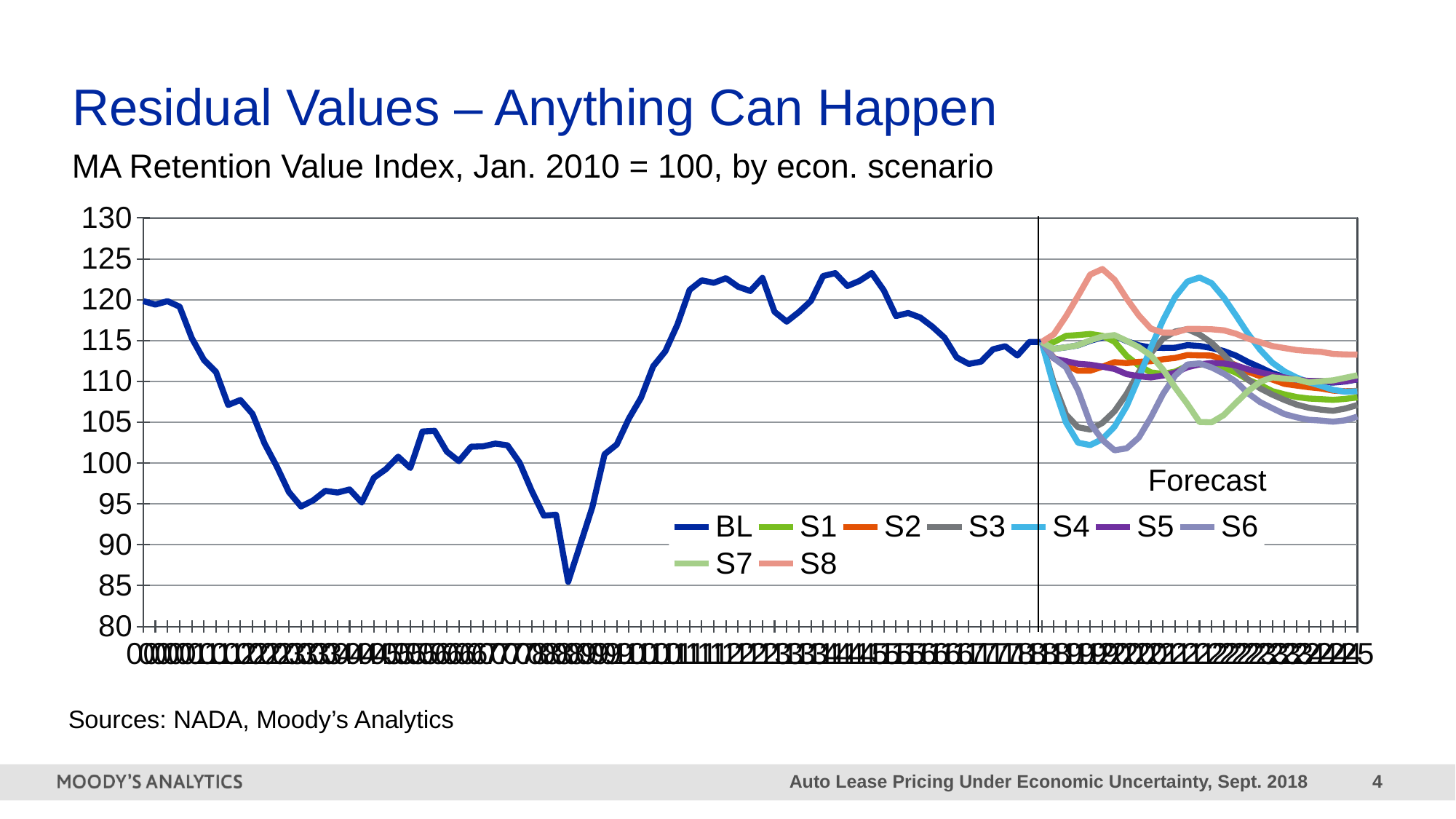
Does the BL line rise or fall from the start of the chart to its deepest trough? fall Is the lowest point of the S4 line in the forecast period greater or less than 105? less How many series does the chart legend list? 9 Is the highest value reached by the BL line greater or less than 120? greater What label is printed inside the chart to the right of the vertical divider line? Forecast At the far right end of the forecast period, which is higher, the S8 line or the S6 line? S8 Is the lowest point of the S6 line in the forecast period greater or less than 105? less What kind of chart is shown on the slide? line chart Which series are listed in the chart legend? BL, S1, S2, S3, S4, S5, S6, S7, S8